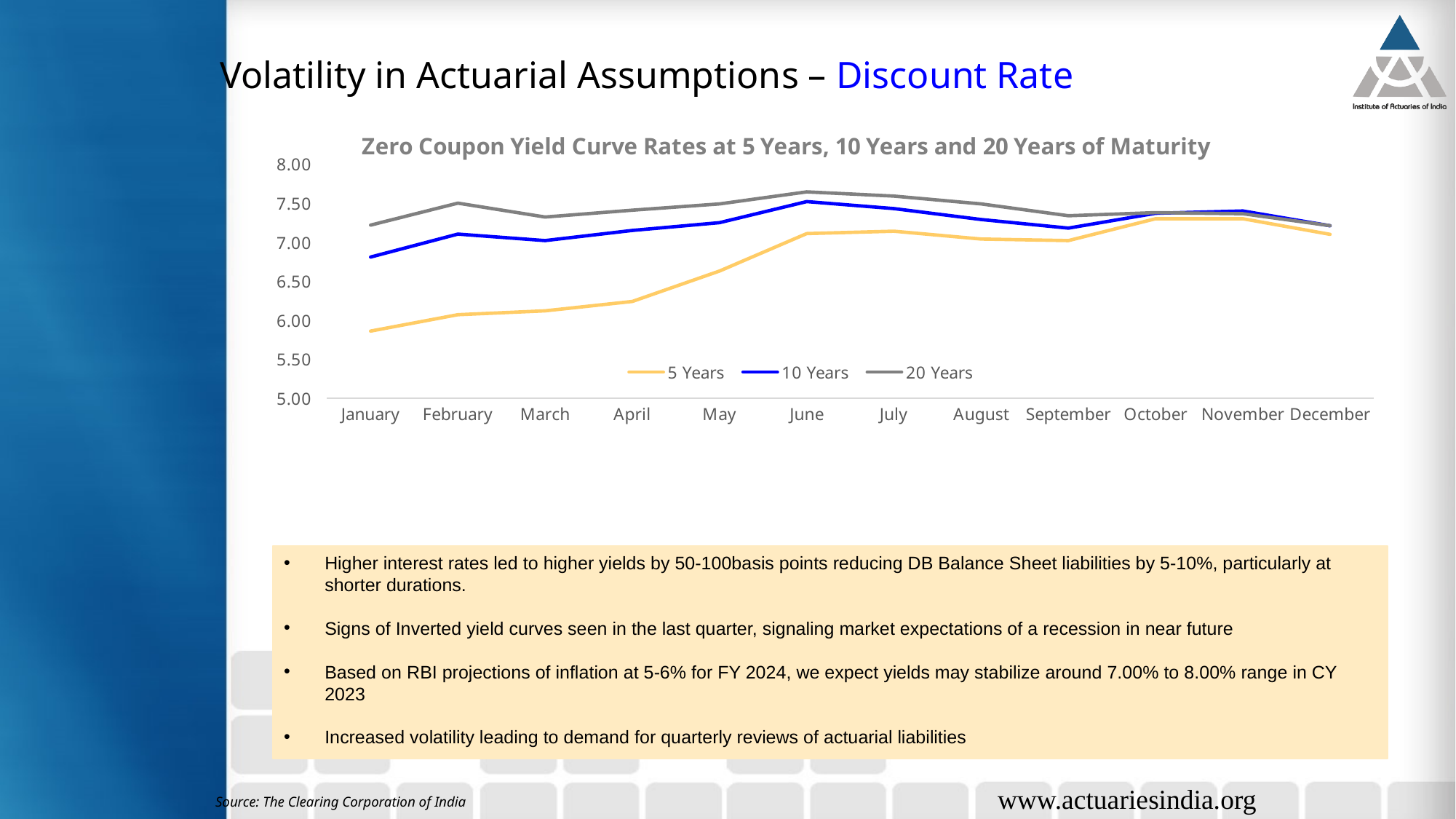
How many months are plotted along the x axis of the chart? 12 What kind of chart is shown on the slide? Line chart Is the 20 Years value for June greater or less than 7.50? greater In January, which series has the larger value: 20 Years or 5 Years? 20 Years In which month does the 20 Years series reach its highest value? June Is the 5 Years value for April greater or less than 6.50? less Does the 5 Years series rise or fall from January to June? Rise In which month is the 5 Years series at its lowest value? January Is the 10 Years value for January greater or less than 7.00? less How many series does the chart's legend list? 3 In which month is the 10 Years series at its lowest value? January